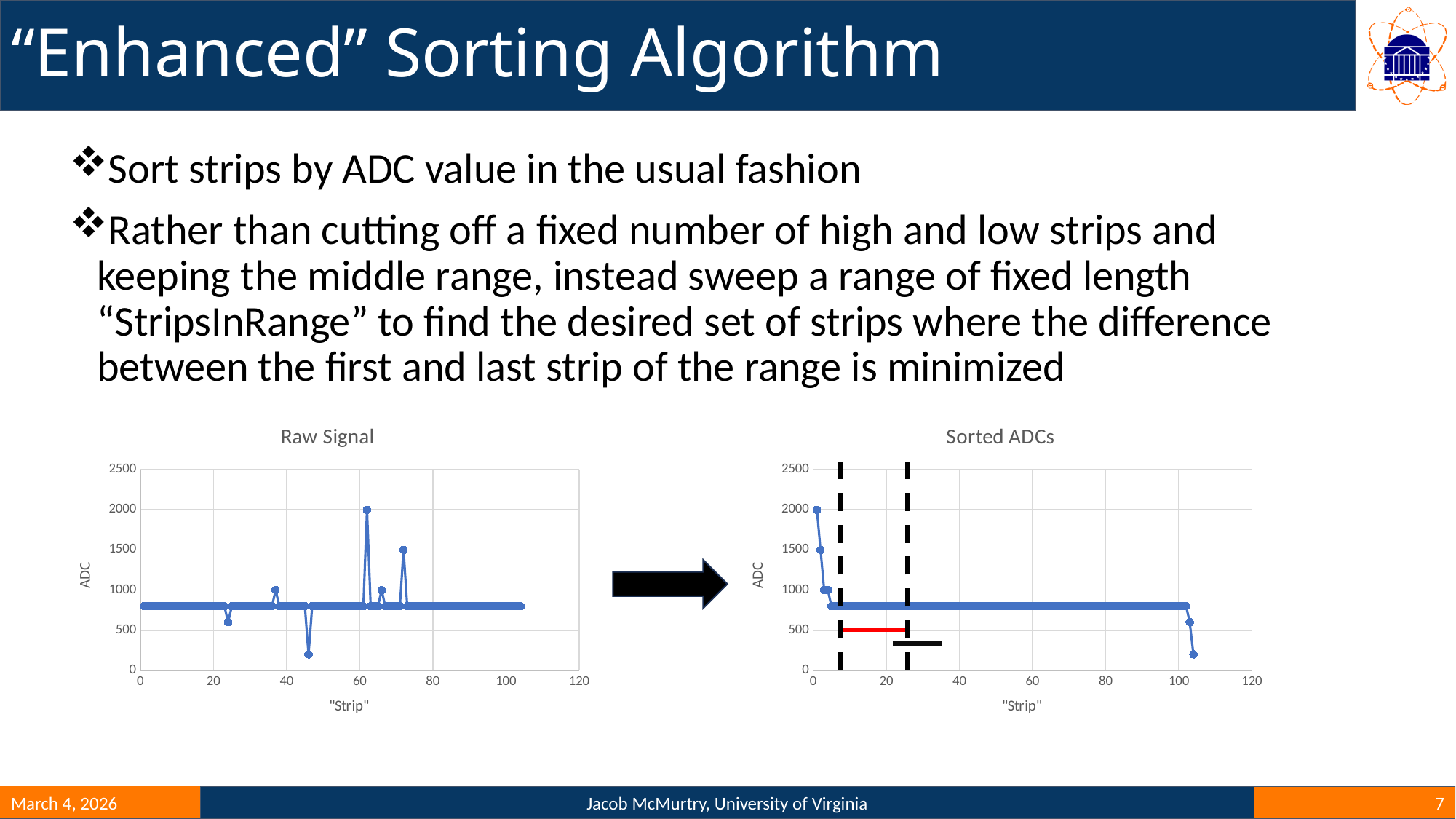
In the "Sorted ADCs" chart, is the last plotted value greater or less than 500? less What kind of chart is the "Raw Signal" chart? line chart In the "Raw Signal" chart, is the lowest plotted value greater or less than 500? less What kind of chart is the "Sorted ADCs" chart? line chart In the "Raw Signal" chart, is the highest plotted value greater or less than 1500? greater In the "Raw Signal" chart, is the peak near strip 62 higher or lower than the peak near strip 72? higher How many charts are shown on the slide? 2 What is the y-axis label of the "Sorted ADCs" chart? ADC In the "Sorted ADCs" chart, do the plotted values rise or fall as the x axis increases? fall What is the title of the chart on the left of the slide? Raw Signal